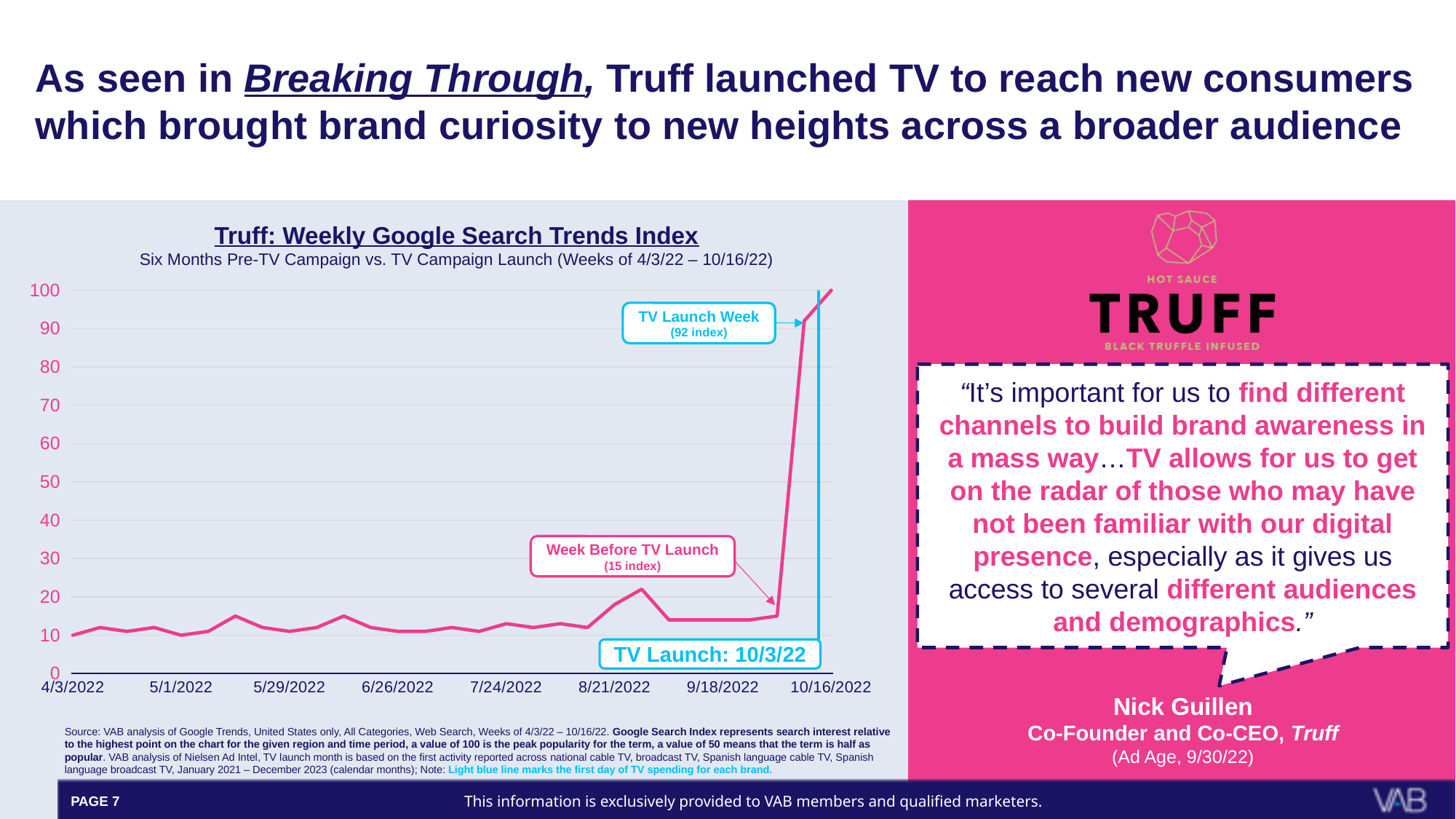
Is the index value for the week of 8/21/2022 greater or less than 20? less Is the index value for the week of 4/3/2022 greater or less than 20? less What TV launch date is marked on the chart? 10/3/22 What kind of chart is shown on the slide? line chart Which has the higher index value: the TV Launch Week or the Week Before TV Launch? TV Launch Week How many date labels are shown on the x axis? 8 What is the index value for the Week Before TV Launch? 15 What is the Google Search Trends index value for the TV Launch Week? 92 Is the index value for the week of 10/16/2022 greater or less than 90? greater By how much did the index rise from the Week Before TV Launch to the TV Launch Week? 77 Does the search index rise or fall between 9/18/2022 and 10/16/2022? rise At which x-axis date does the line reach its highest value? 10/16/2022